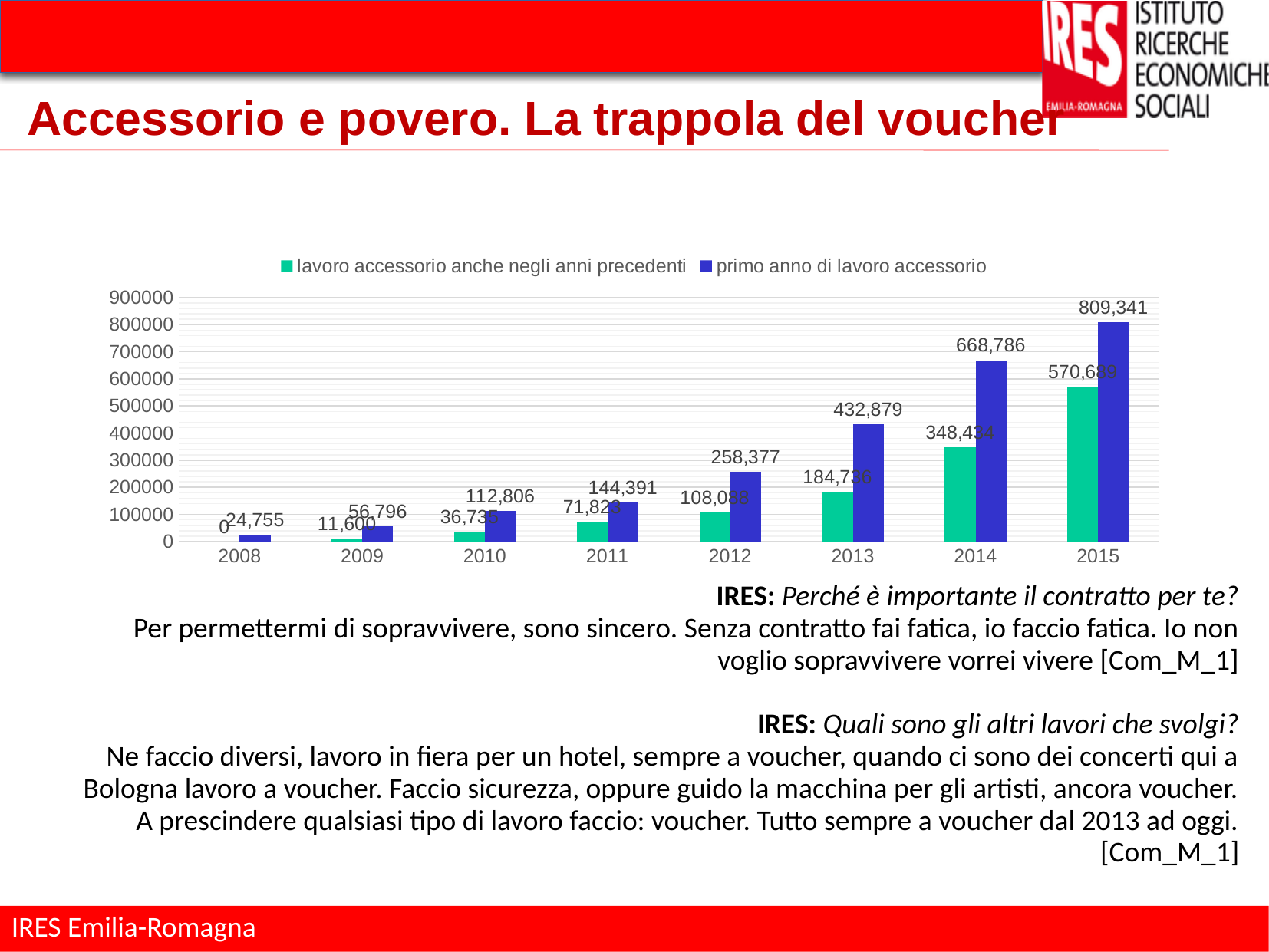
What is the difference between the 'primo anno di lavoro accessorio' values for 2015 and 2014? 140,555 What is the value for 'lavoro accessorio anche negli anni precedenti' in 2009? 11,600 What is the value for 'primo anno di lavoro accessorio' in 2012? 258,377 In which year is 'primo anno di lavoro accessorio' lowest? 2008 Is the value for 'lavoro accessorio anche negli anni precedenti' in 2015 greater or less than 500000? greater How many series does the chart legend list? 2 How many years are shown on the x axis of the chart? 8 What kind of chart is shown on the slide? bar chart Which year has the larger 'primo anno di lavoro accessorio' value, 2013 or 2014? 2014 In which year is 'primo anno di lavoro accessorio' highest? 2015 What is the value for 'primo anno di lavoro accessorio' in 2015? 809,341 Do the 'primo anno di lavoro accessorio' values rise or fall from 2008 to 2015? rise